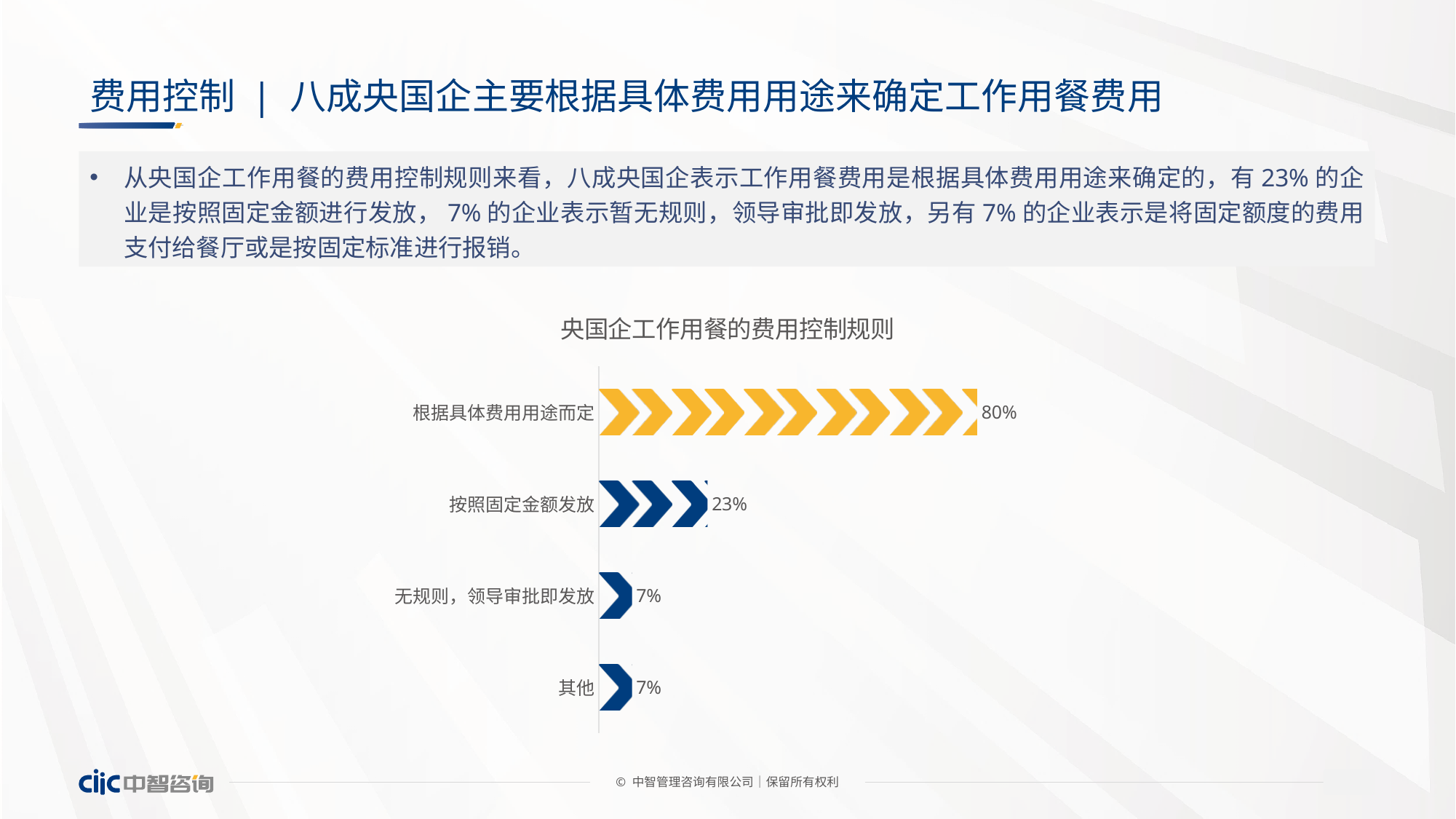
What is the value for 根据具体费用用途而定? 80% What kind of chart is this? bar chart What is the value for 按照固定金额发放? 23% What is the value for 其他? 7% What is the value for 无规则，领导审批即发放? 7% What is the difference between the values for 按照固定金额发放 and 其他? 16% Which category's bar is coloured yellow rather than blue? 根据具体费用用途而定 Which is larger, the value for 按照固定金额发放 or the value for 无规则，领导审批即发放? 按照固定金额发放 What is the difference between the values for 根据具体费用用途而定 and 按照固定金额发放? 57% Which category has the highest value? 根据具体费用用途而定 What is the title of the chart? 央国企工作用餐的费用控制规则 How many categories are shown in the chart? 4